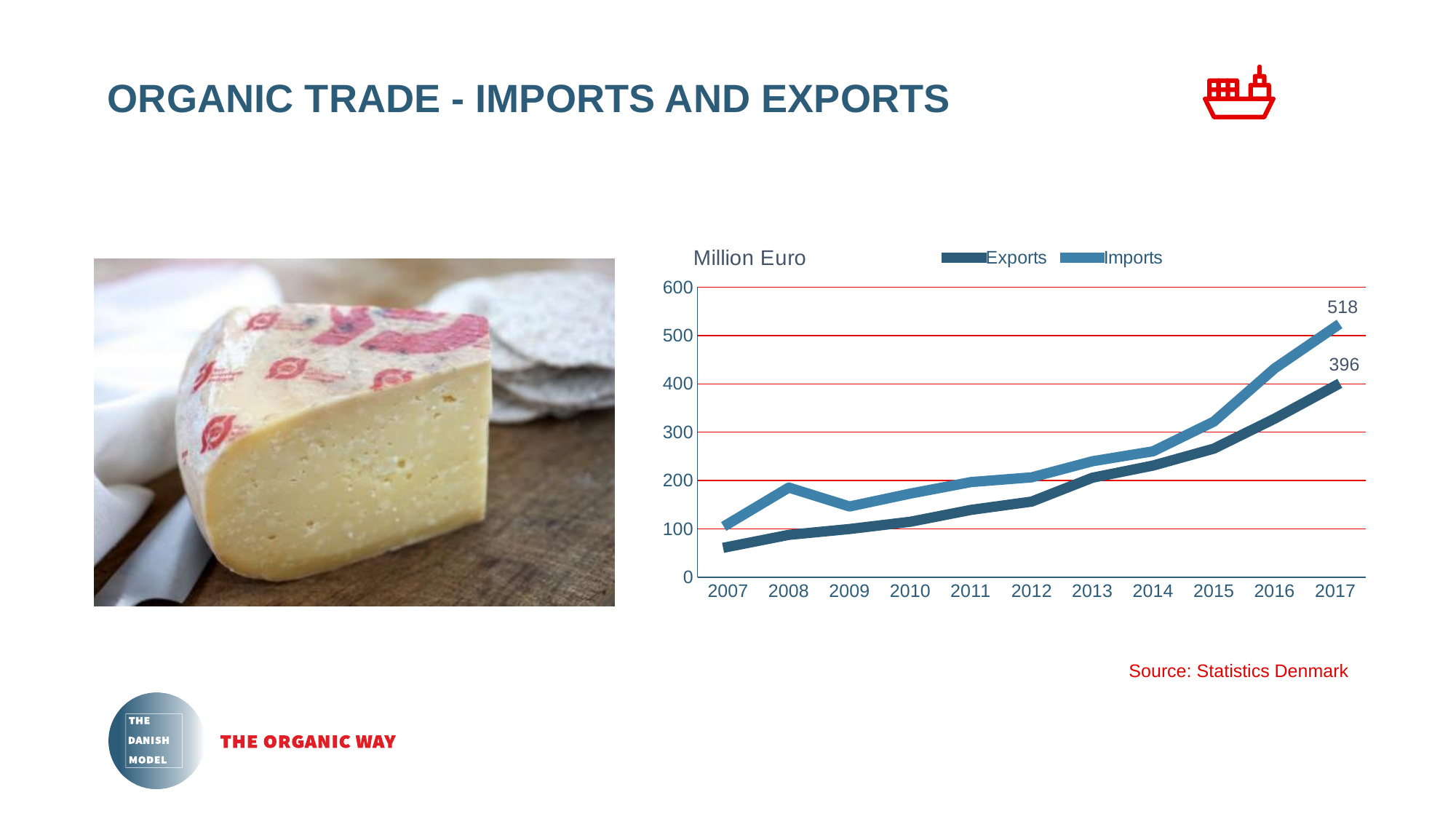
Do Exports rise or fall from 2007 to 2017? rise What kind of chart is shown? line chart How many series does the legend list? 2 Is the value for Exports in 2012 greater or less than 200? less Is the value for Imports in 2016 greater or less than 400? greater What is the value for Exports in 2017? 396 What is the value for Imports in 2017? 518 How many years are shown on the x axis? 11 What is the difference between Imports and Exports in 2017? 122 In 2017, which is larger, Imports or Exports? Imports Is the value for Exports in 2007 greater or less than 100? less What unit is shown above the y axis? Million Euro